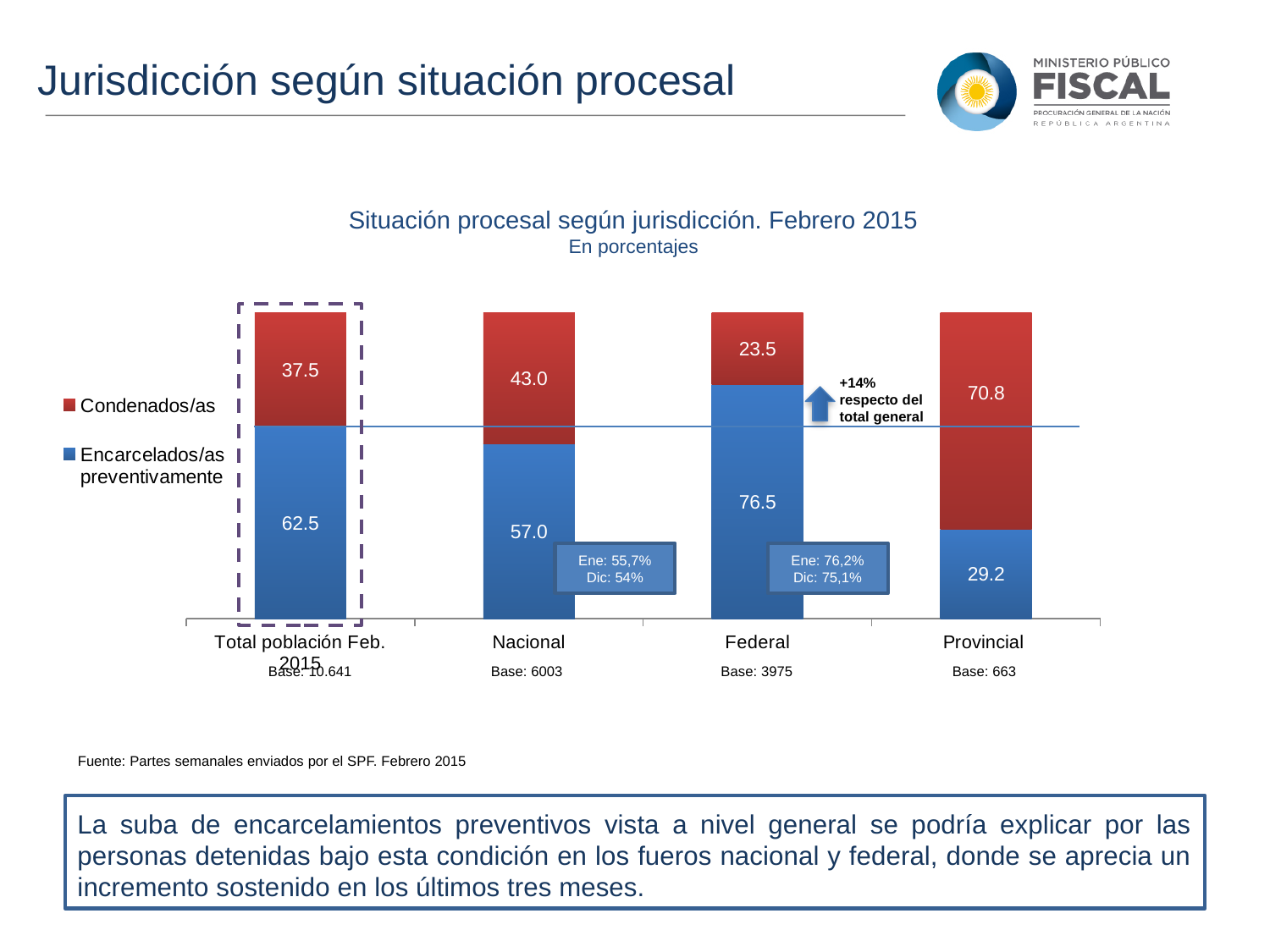
What kind of chart is shown on the slide? Stacked bar chart What is the value for Encarcelados/as preventivamente in the Total población Feb. 2015 category? 62.5 What is the value for Encarcelados/as preventivamente in the Federal category? 76.5 What is the value for Condenados/as in the Provincial category? 70.8 How many series does the legend list? 2 Which is larger: the Condenados/as value for Provincial or for Nacional? Provincial Which category has the highest value for Encarcelados/as preventivamente? Federal What is the difference between the Encarcelados/as preventivamente values for Federal and Nacional? 19.5 What is the value for Condenados/as in the Nacional category? 43.0 Which category has the lowest value for Condenados/as? Federal What is the total of the stacked bar for Provincial? 100.0 How many categories are shown on the x axis? 4